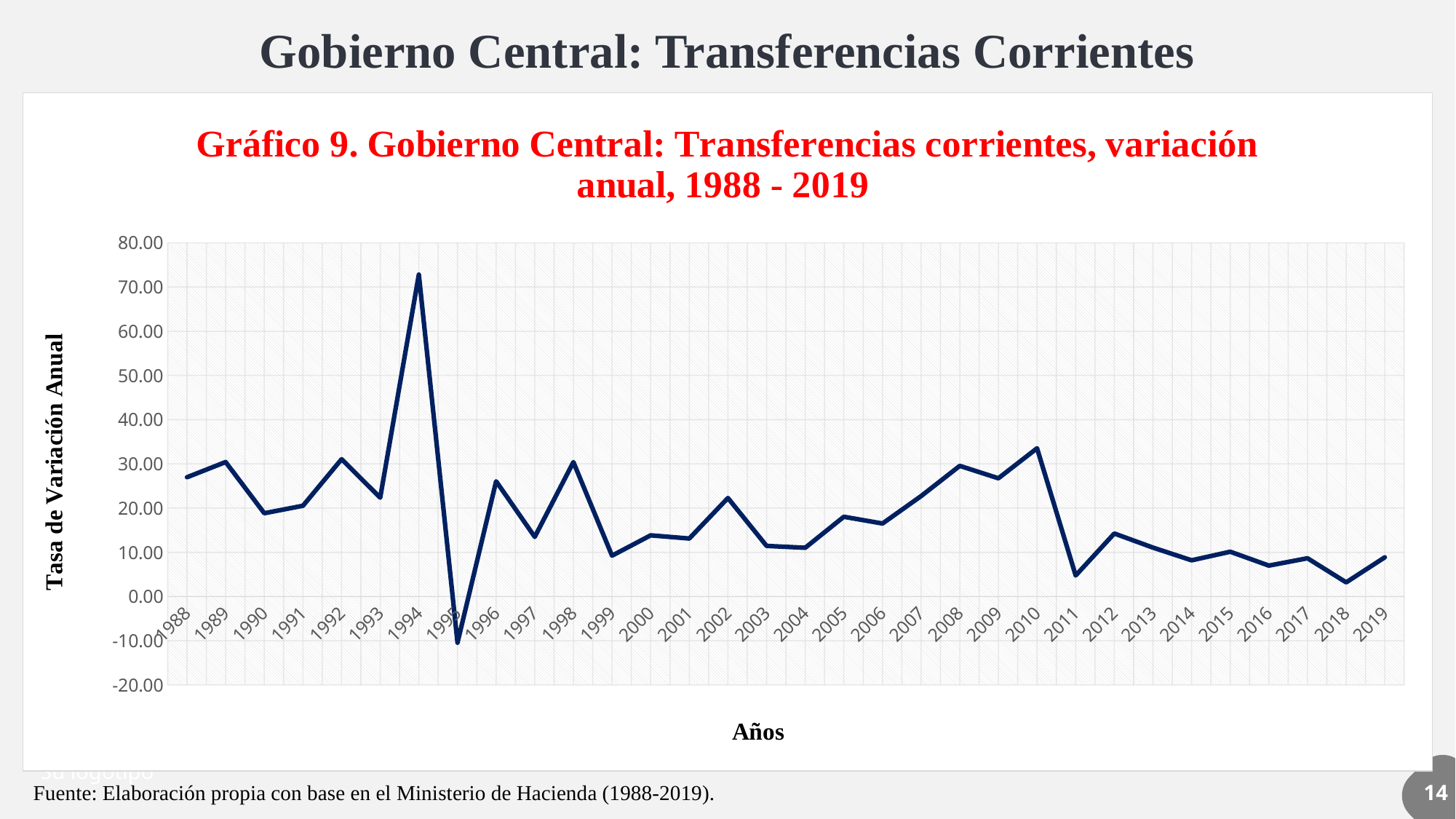
Is the value for 2018 greater or less than 10.00? less Is the value for 1994 greater or less than 60.00? greater Is the value for 2011 greater or less than 10.00? less Which year has the lowest value in the chart? 1995 Which year has the highest value in the chart? 1994 What is the label of the vertical axis? Tasa de Variación Anual What kind of chart is shown on the slide? line chart How many years are plotted along the x axis? 32 Which year has the larger value, 1994 or 2010? 1994 Does the value rise or fall from 2010 to 2011? fall